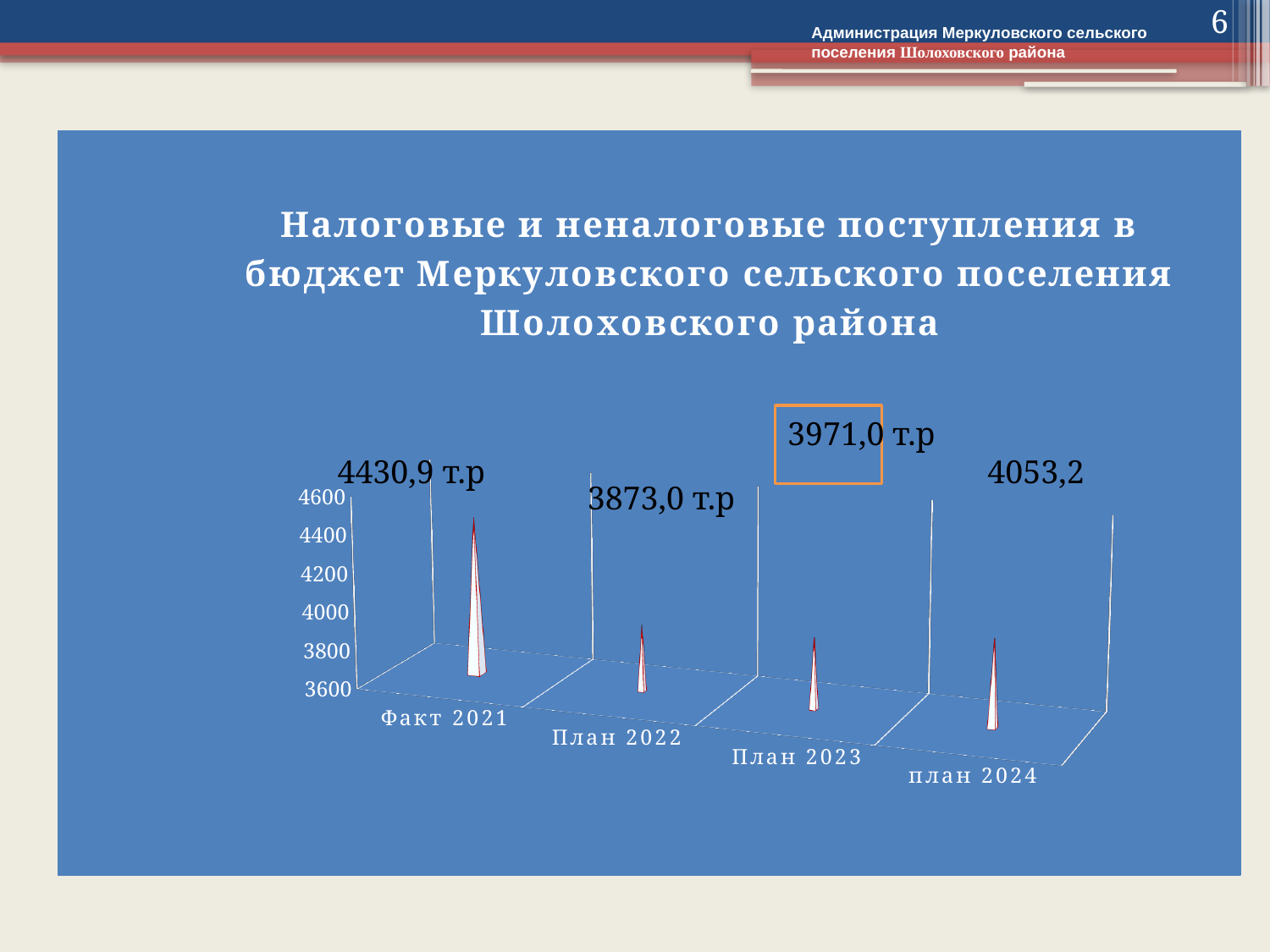
Which category has the lowest value? План 2022 Which is larger, the value for План 2023 or the value for План 2022? План 2023 What is the difference between the values for Факт 2021 and План 2022? 557,9 What value is shown for План 2022? 3873,0 т.р What is the difference between the values for план 2024 and План 2023? 82,2 How many categories are shown on the x axis? 4 Do the values rise or fall from План 2022 to план 2024? rise What value is shown for план 2024? 4053,2 What value is shown for План 2023? 3971,0 т.р What value is shown for Факт 2021? 4430,9 т.р What kind of chart is shown on the slide? bar chart Which category has the highest value? Факт 2021